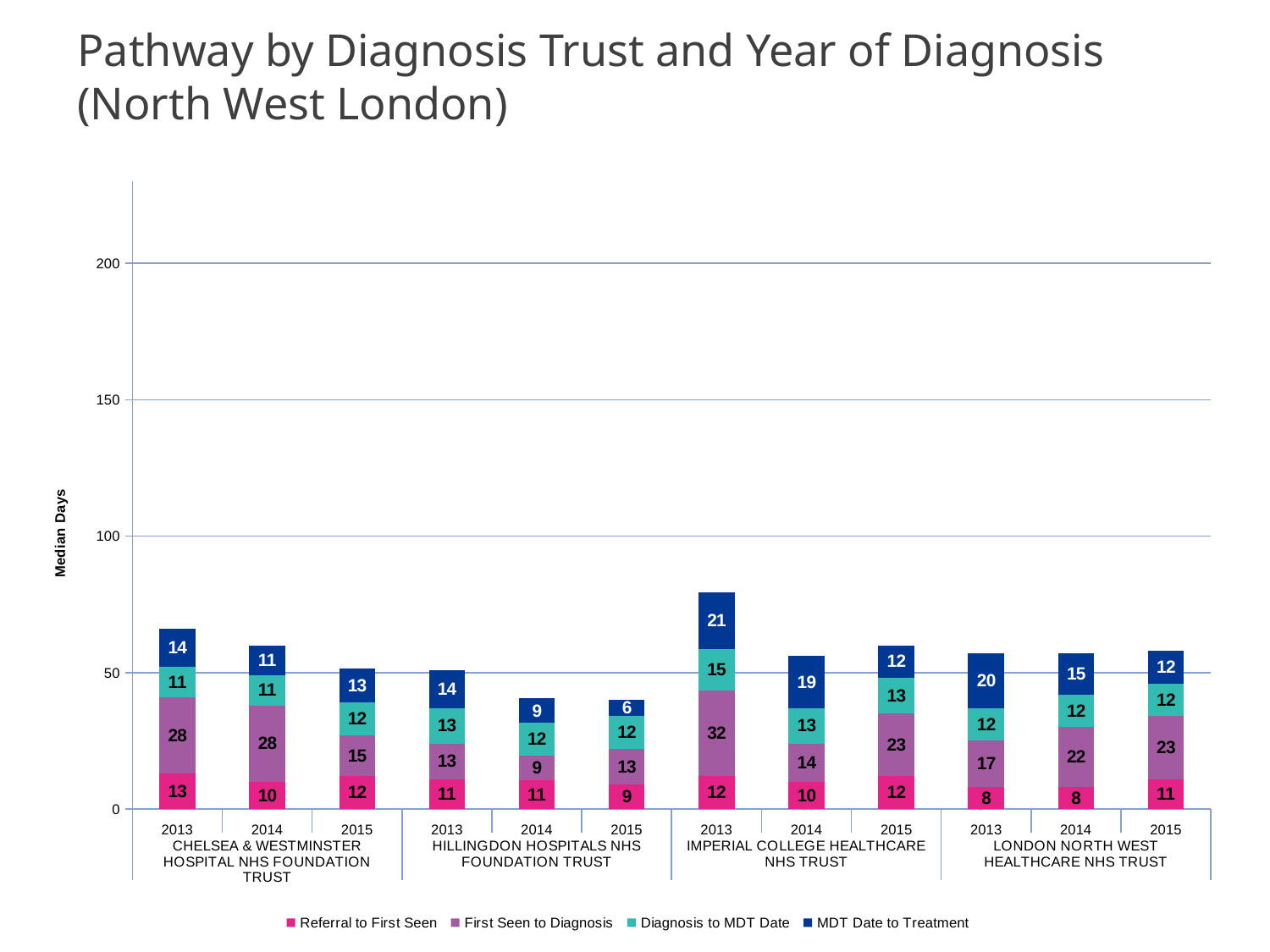
What is the First Seen to Diagnosis value for Imperial College Healthcare NHS Trust in 2013? 32 What kind of chart is shown on the slide? Stacked bar chart What is the Referral to First Seen value for London North West Healthcare NHS Trust in 2014? 8 What is the total of the stacked bar for Hillingdon Hospitals NHS Foundation Trust in 2014? 41 What is the label on the vertical axis? Median Days Which is larger: the MDT Date to Treatment value for Imperial College Healthcare NHS Trust in 2013 or for London North West Healthcare NHS Trust in 2013? Imperial College Healthcare NHS Trust 2013 How many series does the legend list? 4 What is the total of the stacked bar for Imperial College Healthcare NHS Trust in 2013? 80 What is the MDT Date to Treatment value for Hillingdon Hospitals NHS Foundation Trust in 2015? 6 Which bar has the highest total median days? Imperial College Healthcare NHS Trust 2013 How many bars are plotted in the chart? 12 What is the difference between the First Seen to Diagnosis values for Chelsea & Westminster Hospital NHS Foundation Trust in 2014 and 2015? 13